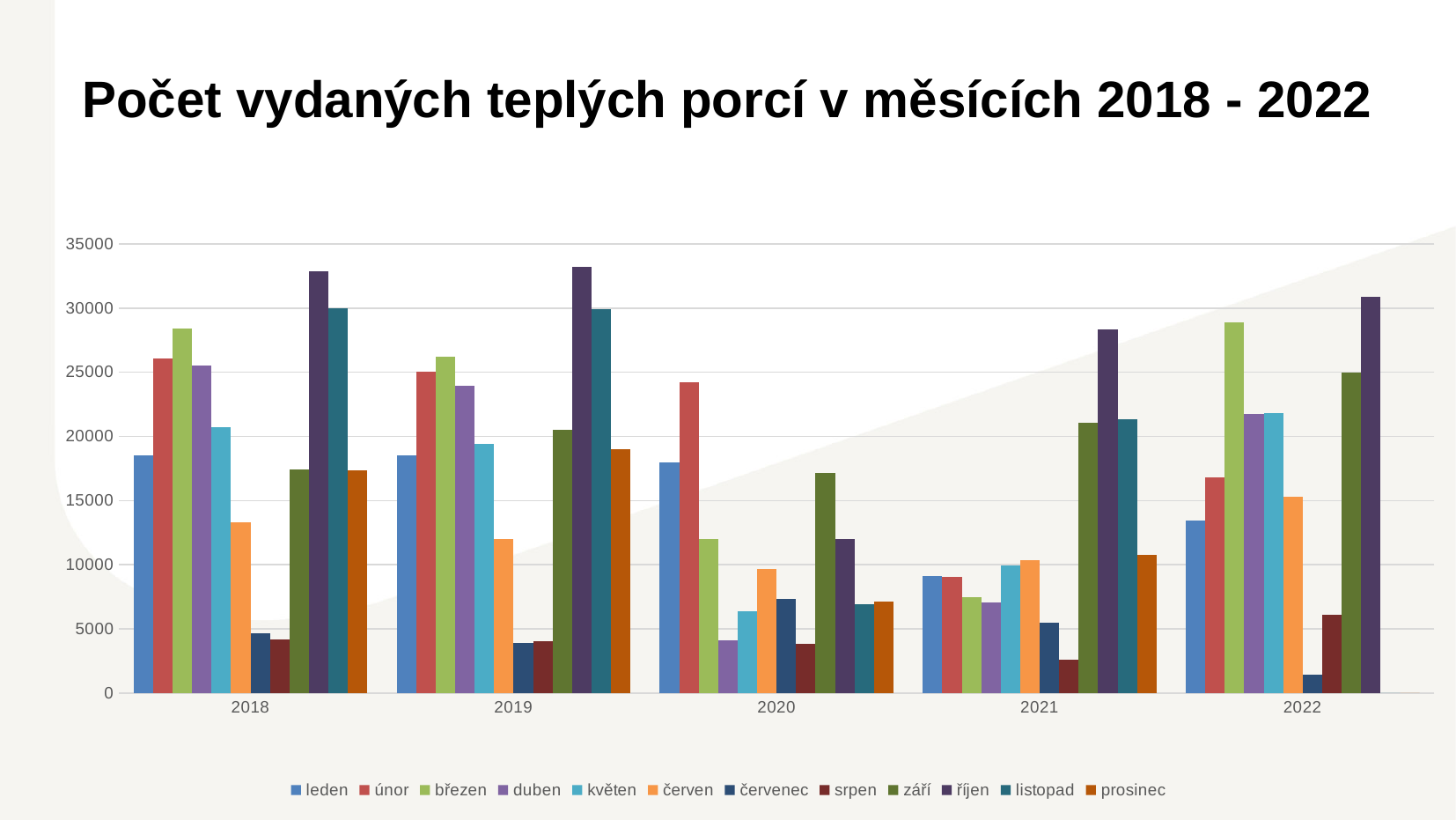
Is the value for říjen in 2019 greater or less than 30000? greater How many years (categories) are shown on the x axis? 5 Which month has the highest value in 2018? říjen How many series does the legend list? 12 Is the value for srpen in 2021 greater or less than 5000? less Is the value for únor in 2020 greater or less than 20000? greater What is the title of the chart? Počet vydaných teplých porcí v měsících 2018 - 2022 Which month has the lowest value in 2021? srpen Which month has the highest value in 2022? říjen What kind of chart is shown on the slide? bar chart Which is larger: the value for leden in 2021 or the value for leden in 2022? leden in 2022